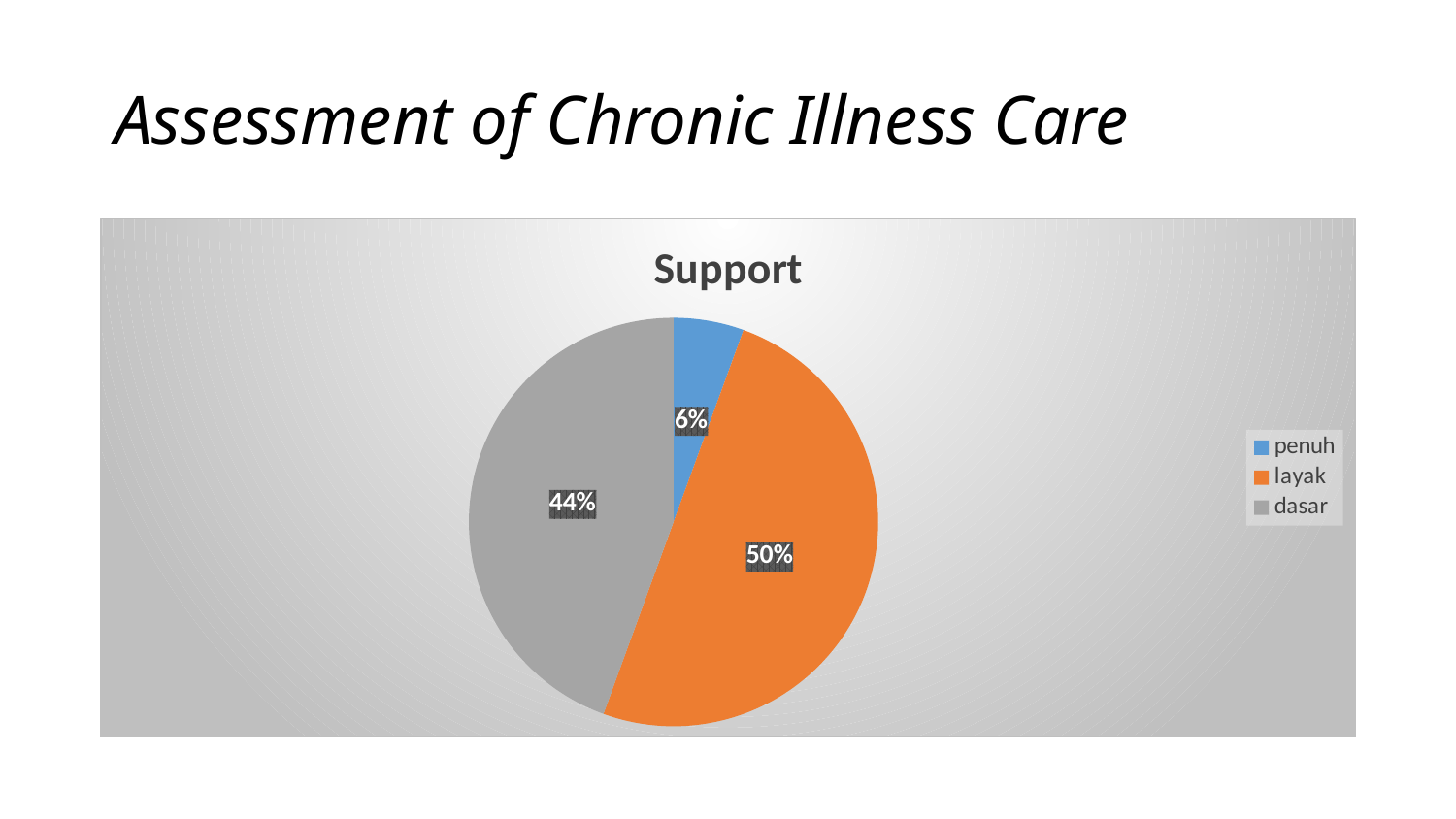
Which category has the smallest slice of the pie? penuh Which is larger, the 'dasar' slice or the 'penuh' slice? dasar What colour is the 'layak' slice? orange Which category has the largest slice of the pie? layak What share of the pie does the 'penuh' slice represent? 6% How many categories does the legend list? 3 What is the difference in percentage points between the 'dasar' and 'penuh' slices? 38% What is the title of the chart? Support What share of the pie does the 'dasar' slice represent? 44% What type of chart is shown on the slide? pie chart What share of the pie does the 'layak' slice represent? 50% What is the difference in percentage points between the 'layak' and 'dasar' slices? 6%